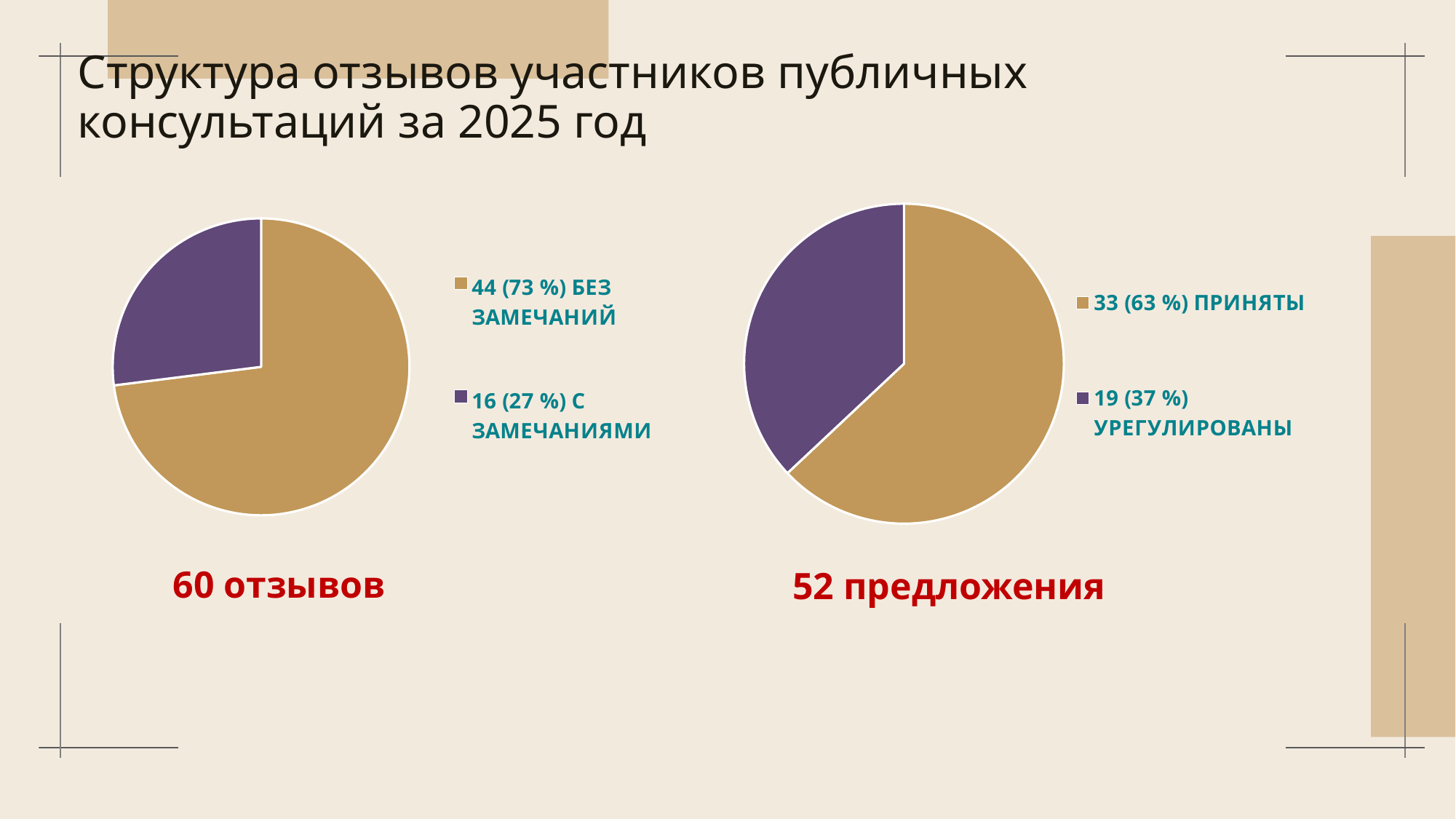
In the right pie chart (52 предложения), how many proposals are labelled ПРИНЯТЫ? 33 In the right pie chart (52 предложения), what is the difference between the ПРИНЯТЫ count and the УРЕГУЛИРОВАНЫ count? 14 What kind of chart is the left chart (60 отзывов)? Pie chart In the left pie chart (60 отзывов), what share of the pie is С ЗАМЕЧАНИЯМИ? 27 % What is the total number of reviews shown under the left pie chart? 60 отзывов In the right pie chart (52 предложения), what colour is the ПРИНЯТЫ slice? Tan (gold-brown) In the left pie chart (60 отзывов), how many reviews are labelled БЕЗ ЗАМЕЧАНИЙ? 44 How many slices does the left pie chart (60 отзывов) have? 2 In the left pie chart (60 отзывов), what is the difference between the БЕЗ ЗАМЕЧАНИЙ count and the С ЗАМЕЧАНИЯМИ count? 28 In the right pie chart (52 предложения), what share of the pie is УРЕГУЛИРОВАНЫ? 37 % In the right pie chart (52 предложения), which slice is the smallest? УРЕГУЛИРОВАНЫ In the left pie chart (60 отзывов), which slice is larger: БЕЗ ЗАМЕЧАНИЙ or С ЗАМЕЧАНИЯМИ? БЕЗ ЗАМЕЧАНИЙ